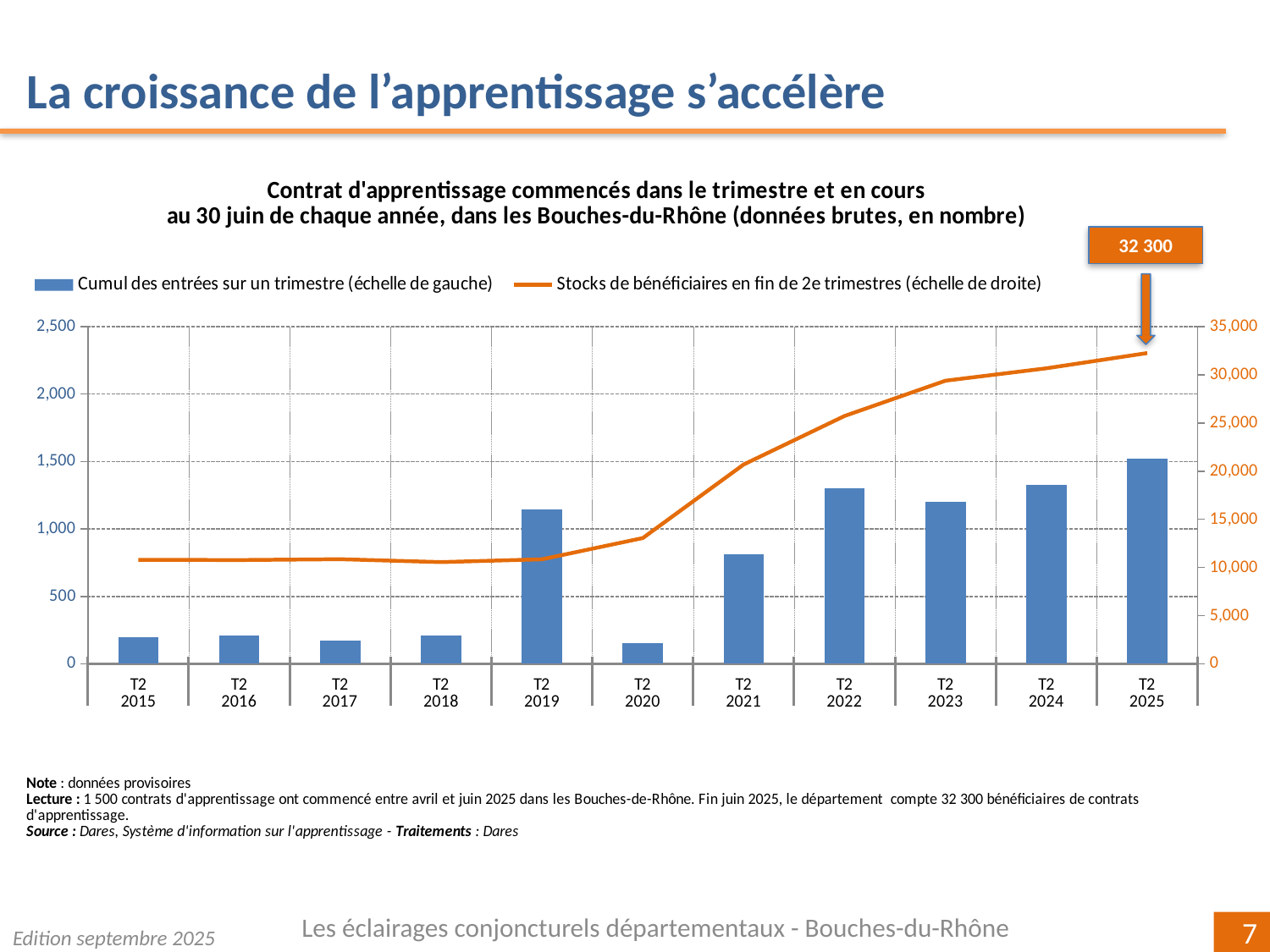
Which quarter has the highest bar for 'Cumul des entrées sur un trimestre'? T2 2025 Is the bar value for T2 2021 greater or less than 1,000? less What is the value of the stock of beneficiaries (Stocks de bénéficiaires) at T2 2025? 32 300 Is the bar value for T2 2019 greater or less than 1,000? greater What colour is the 'Stocks de bénéficiaires en fin de 2e trimestres' line? Orange What kind of chart is shown on the slide? A combined bar and line chart Which bar is taller, T2 2023 or T2 2024? T2 2024 Does the 'Stocks de bénéficiaires' line rise or fall between T2 2020 and T2 2025? It rises How many series does the legend list? 2 Which bar is taller, T2 2022 or T2 2023? T2 2022 Is the stock of beneficiaries at T2 2015 greater or less than 15,000 on the right-hand axis? less How many quarters (categories) are shown on the x axis? 11